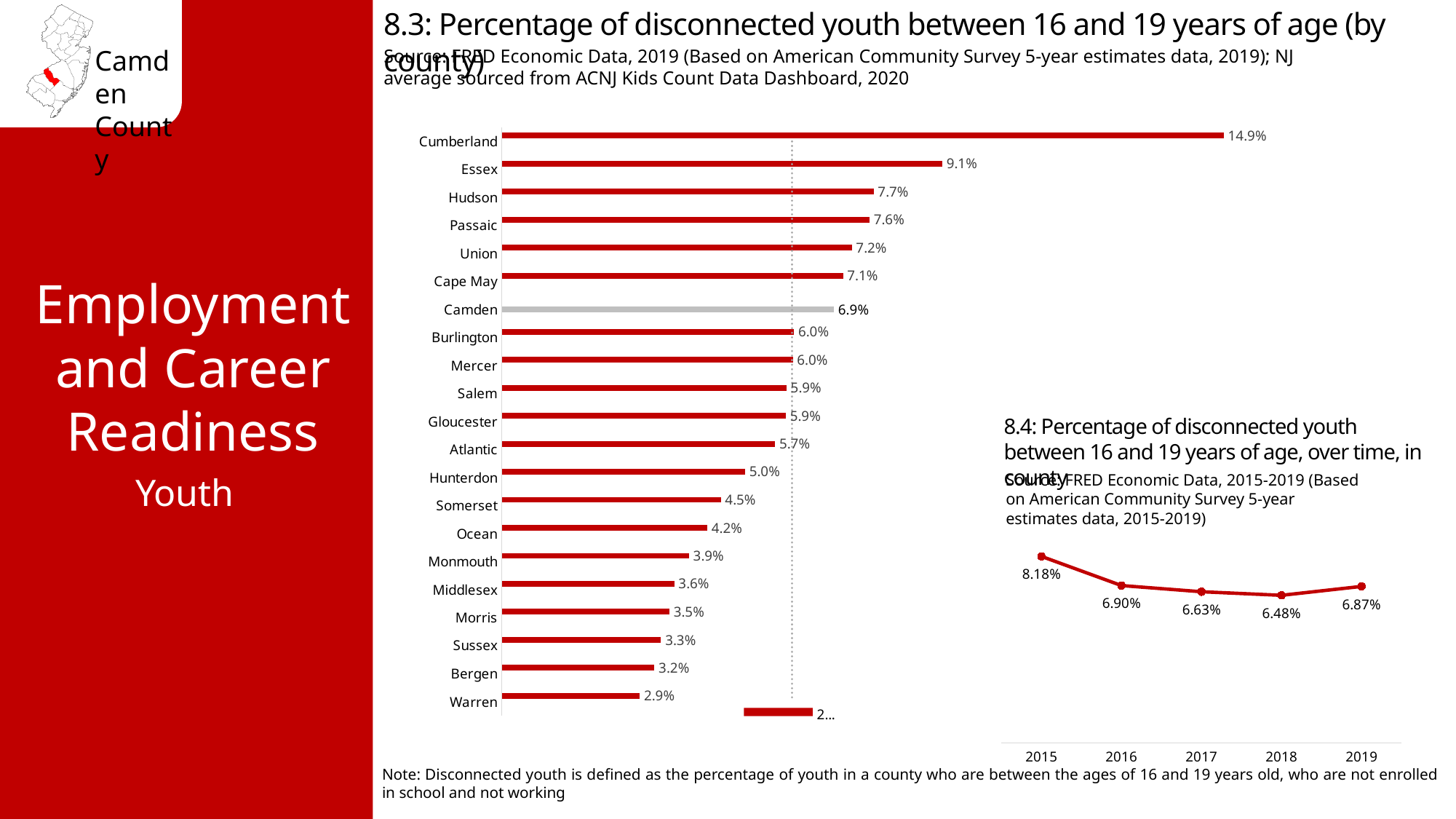
In chart 8.3 (percentage of disconnected youth by county), which is larger, the value for Hudson or the value for Ocean? Hudson In chart 8.3 (percentage of disconnected youth by county), which county has the highest value? Cumberland What kind of chart is chart 8.4 (percentage of disconnected youth over time)? Line chart In chart 8.3 (percentage of disconnected youth by county), what is the value for Camden? 6.9% In chart 8.4 (percentage of disconnected youth over time), what is the difference between the 2015 and 2018 values? 1.70 percentage points In chart 8.3 (percentage of disconnected youth by county), how many counties are plotted? 21 In chart 8.4 (percentage of disconnected youth over time), what is the value for 2015? 8.18% In chart 8.3 (percentage of disconnected youth by county), which county has the lowest value? Warren What kind of chart is chart 8.3 (percentage of disconnected youth by county)? Bar chart In chart 8.3 (percentage of disconnected youth by county), what is the value for Bergen? 3.2% In chart 8.4 (percentage of disconnected youth over time), which year has the lowest value? 2018 In chart 8.3 (percentage of disconnected youth by county), what is the difference between Cumberland and Essex? 5.8 percentage points